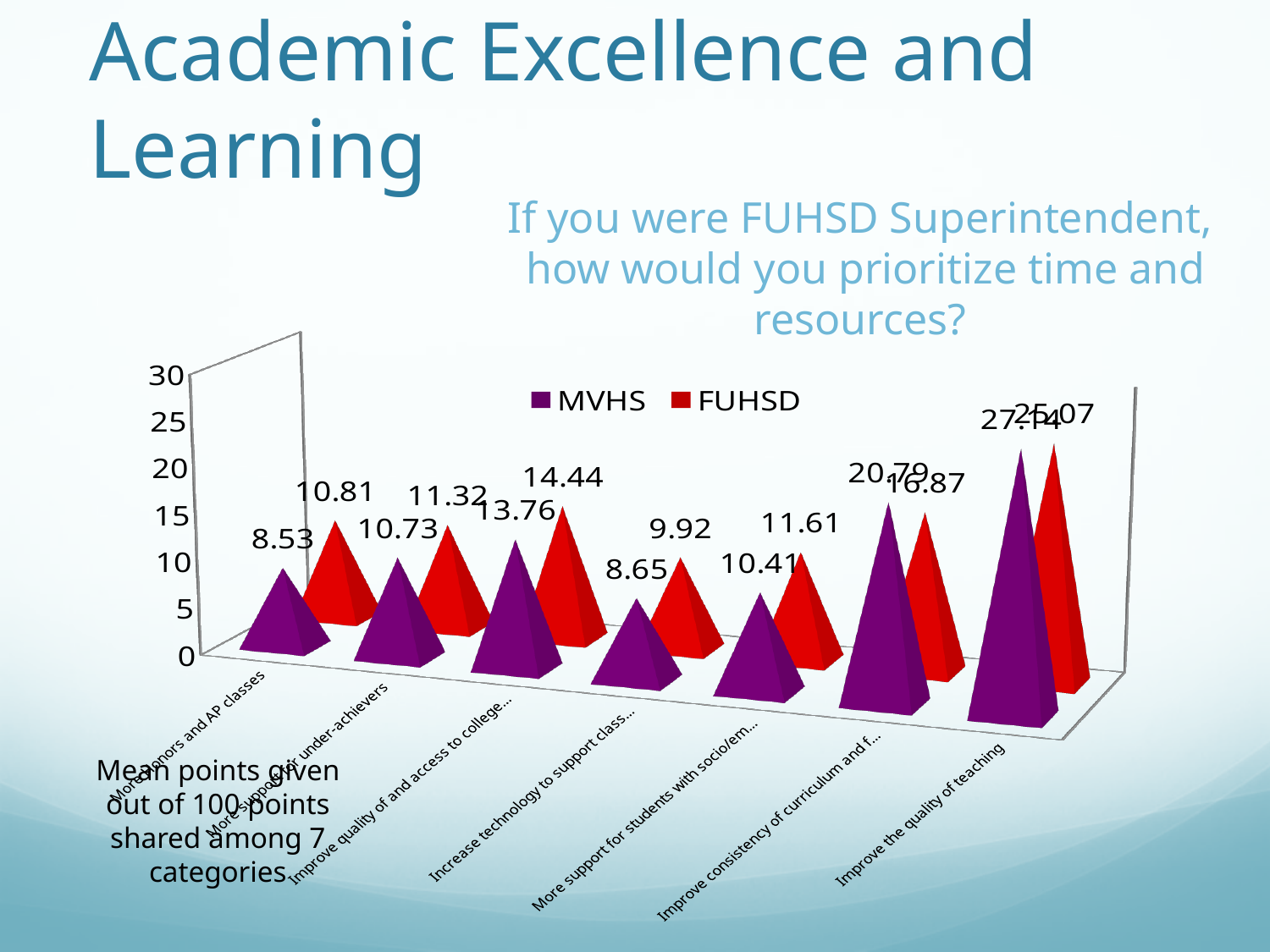
How many series does the chart legend list? 2 How many categories are plotted along the x axis of the chart? 7 What is the FUHSD value for 'Increase technology to support class...'? 9.92 Which category has the highest MVHS value? Improve the quality of teaching What is the MVHS value for 'Improve consistency of curriculum and f...'? 20.79 What is the difference between the MVHS and FUHSD values for 'Improve consistency of curriculum and f...'? 3.92 What are the two series named in the chart legend? MVHS and FUHSD What is the FUHSD value for 'Improve consistency of curriculum and f...'? 16.87 What is the FUHSD value for 'More support for students with socio/em...'? 11.61 What is the MVHS value for 'Improve quality of and access to college...'? 13.76 What kind of chart is shown on the slide? bar chart For 'Improve consistency of curriculum and f...', which series has the larger value, MVHS or FUHSD? MVHS